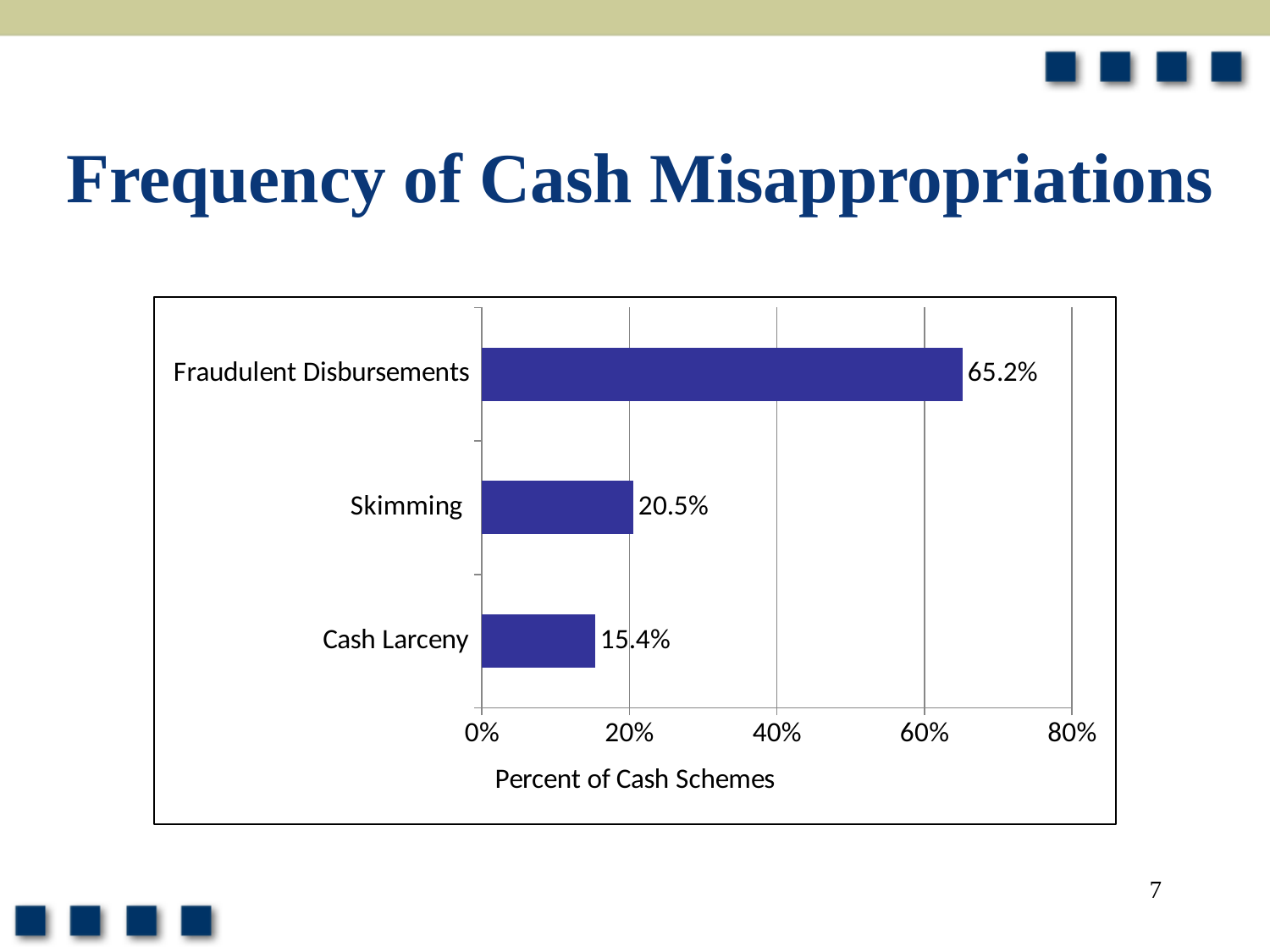
What is the label of the horizontal axis? Percent of Cash Schemes Which category has the lowest value? Cash Larceny What kind of chart is shown on the slide? bar chart What is the difference between the values for Skimming and Cash Larceny? 5.1% How many categories are shown in the chart? 3 What is the difference between the values for Fraudulent Disbursements and Skimming? 44.7% What is the value for Cash Larceny? 15.4% Which is larger, the value for Skimming or the value for Cash Larceny? Skimming What is the value for Skimming? 20.5% Which category has the highest value? Fraudulent Disbursements Is the value for Fraudulent Disbursements greater or less than 60%? greater What is the value for Fraudulent Disbursements? 65.2%